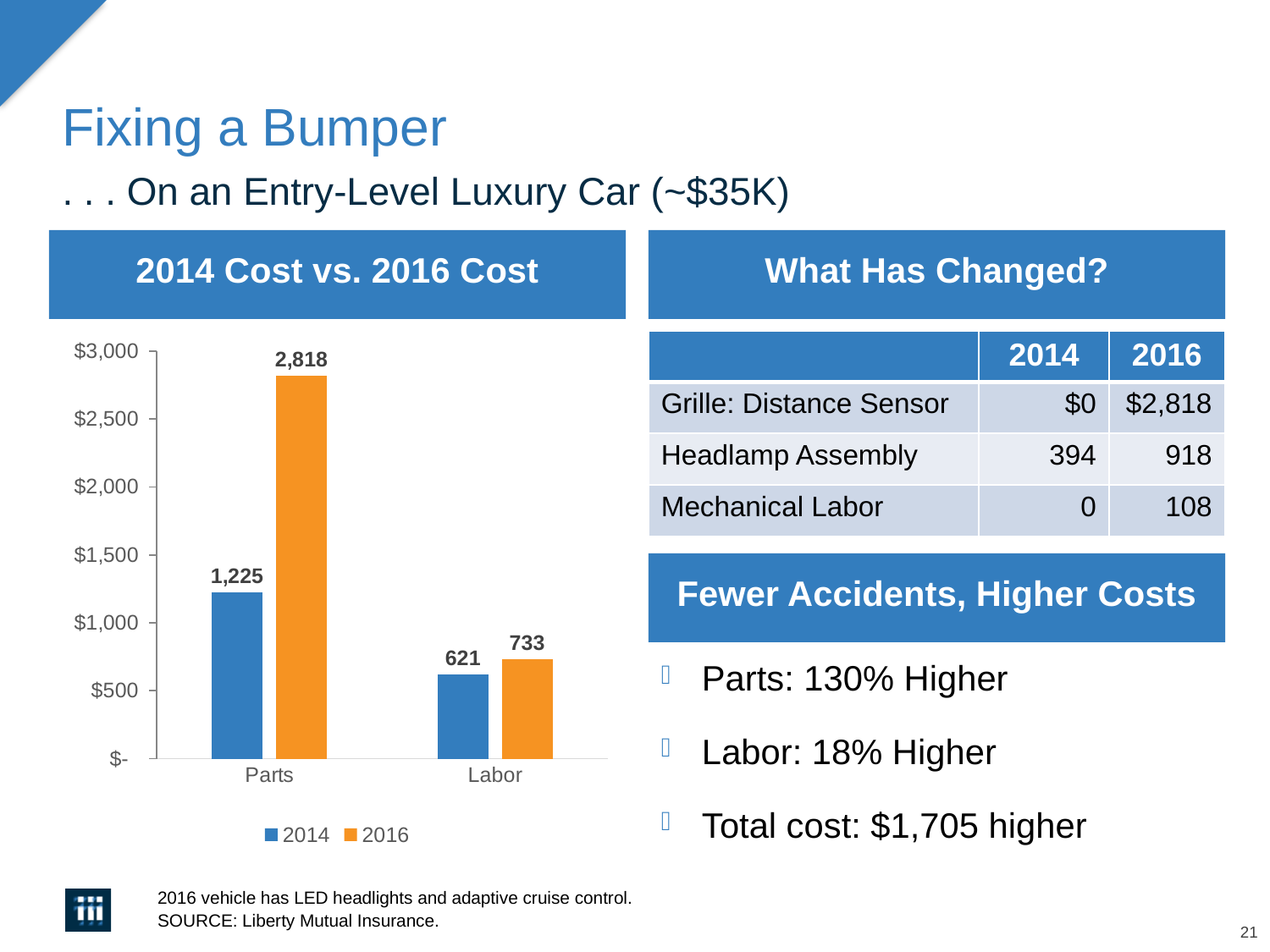
What is the 2016 value for Labor? 733 What is the 2014 value for Labor? 621 What type of chart is shown on the slide? Bar chart Which is larger, the 2014 value for Parts or the 2016 value for Labor? 2014 value for Parts Which bar is the tallest in the chart? Parts, 2016 What is the difference between the 2016 and 2014 values for Parts? 1,593 What is the 2016 value for Parts? 2,818 What is the 2014 value for Parts? 1,225 What is the difference between the 2016 and 2014 values for Labor? 112 How many series does the legend list? 2 How many categories are shown on the x axis? 2 Which bar is the shortest in the chart? Labor, 2014